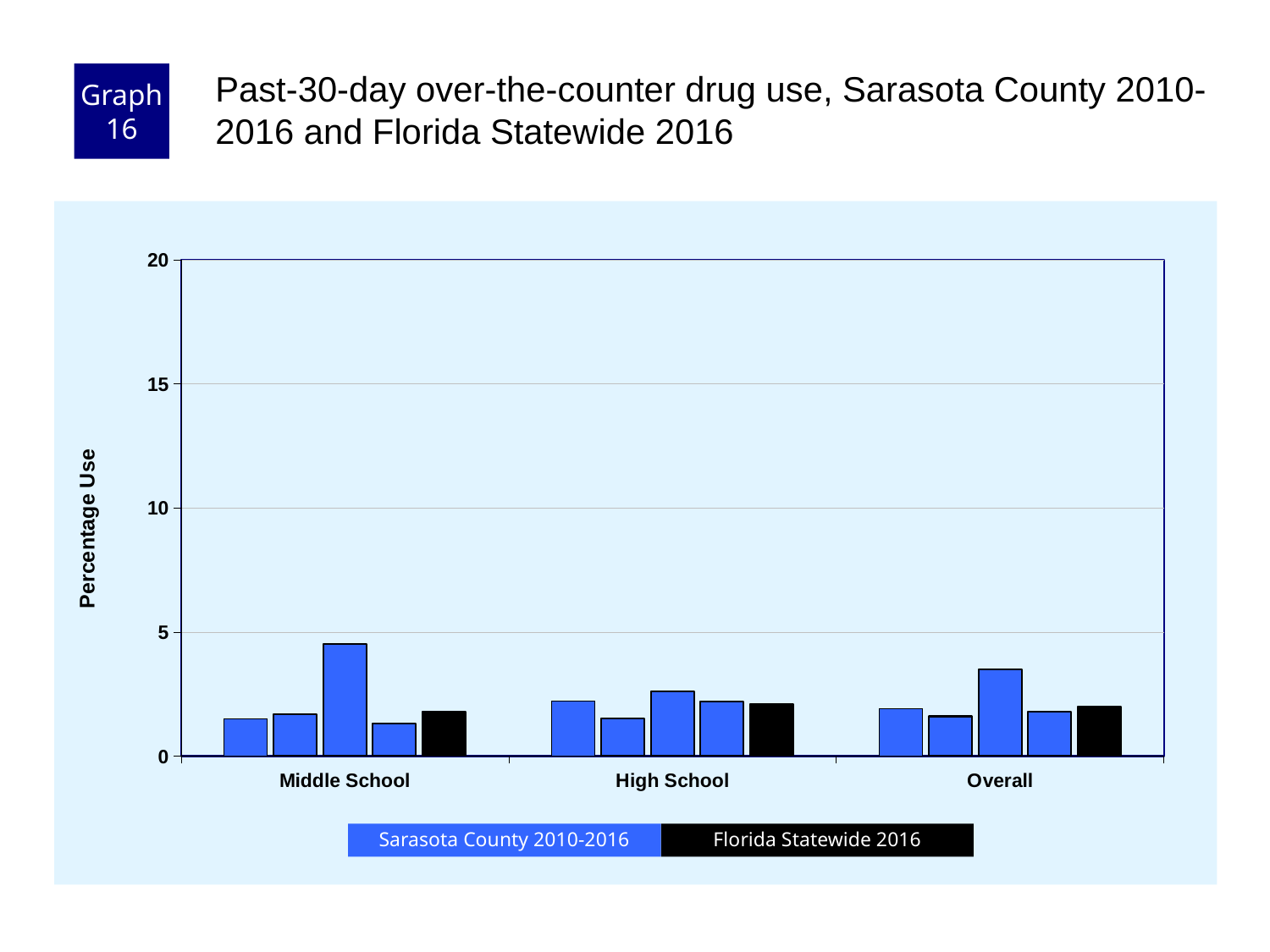
What kind of chart is shown on the slide? bar chart What is the label of the y axis? Percentage Use Is the Florida Statewide 2016 value for High School greater or less than 5? less Is the tallest bar in the Middle School group greater or less than 5? less What is the highest value shown on the y axis? 20 Is the Florida Statewide 2016 value for Middle School greater or less than 5? less Which x-axis category contains the tallest bar on the chart? Middle School Which colour represents Florida Statewide 2016 in the legend? black How many categories are shown on the x axis? 3 How many series does the legend list? 2 How many bars are shown for each x-axis category? 5